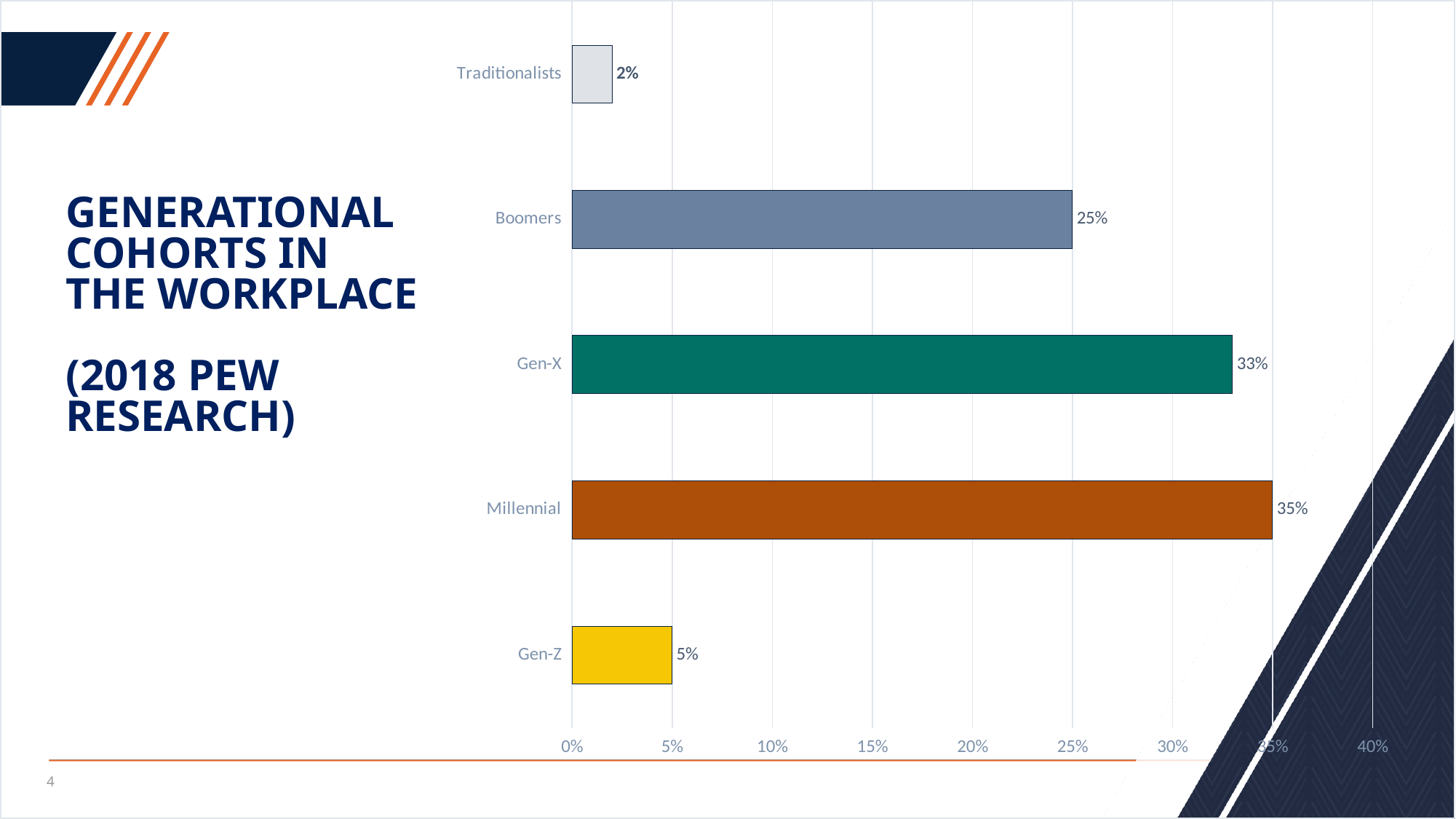
What is the difference between the values for Gen-X and Boomers? 8% Is the value for Gen-X greater or less than 30%? greater Which is larger, the value for Boomers or the value for Gen-Z? Boomers What is the value for Boomers? 25% How many generational cohorts are shown in the chart? 5 What is the difference between the values for Gen-Z and Traditionalists? 3% What is the value for Traditionalists? 2% What is the value for Millennial? 35% What kind of chart is shown on the slide? Bar chart What is the value for Gen-Z? 5% Which generational cohort has the highest value? Millennial Which generational cohort has the lowest value? Traditionalists